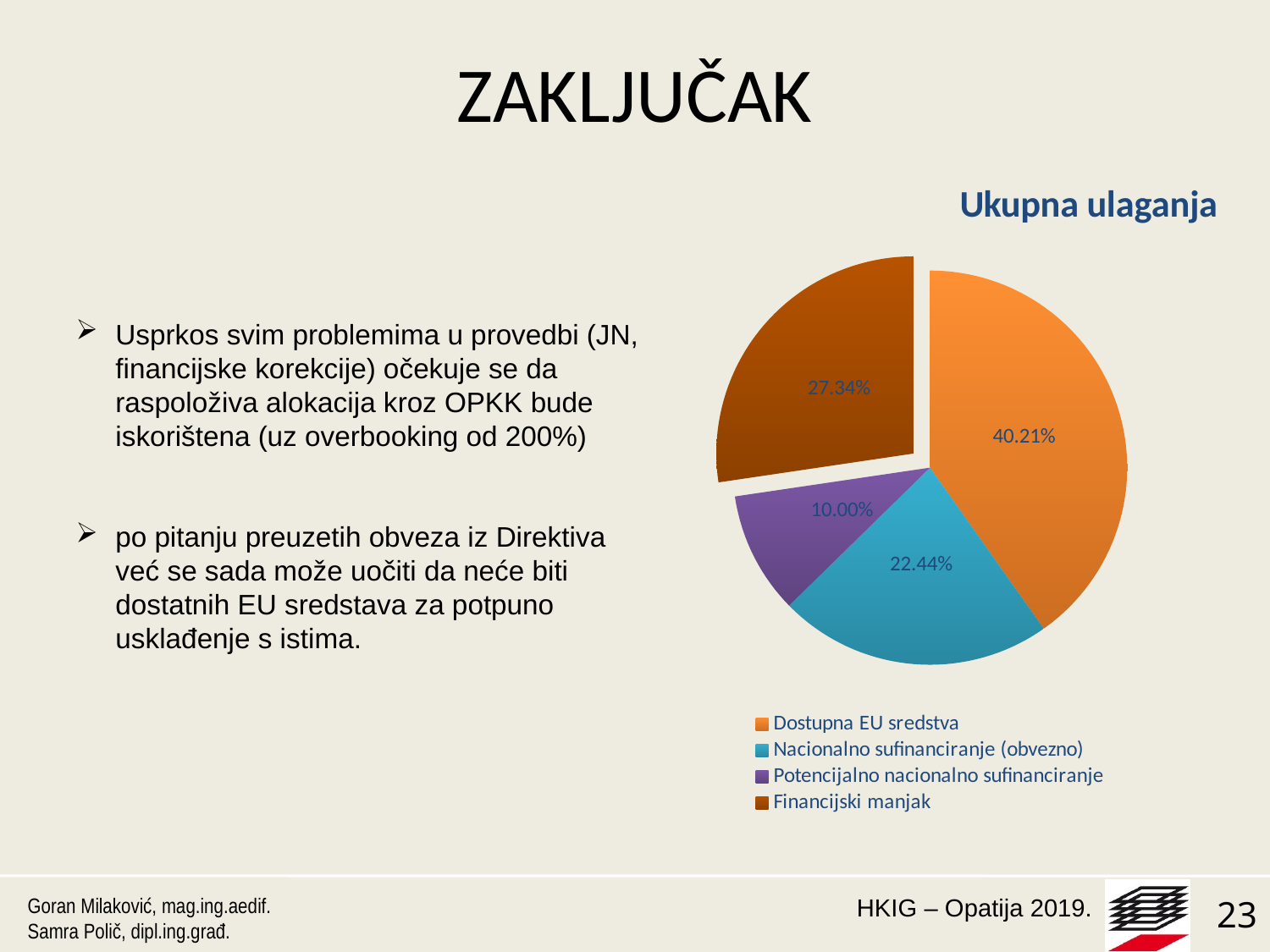
How many slices does the pie chart have? 4 What share of the pie is Nacionalno sufinanciranje (obvezno)? 22.44% What is the title of the chart? Ukupna ulaganja Which slice of the pie is the smallest? Potencijalno nacionalno sufinanciranje Which slice of the pie is the largest? Dostupna EU sredstva Which is larger, the share for Financijski manjak or the share for Nacionalno sufinanciranje (obvezno)? Financijski manjak What share of the pie is Potencijalno nacionalno sufinanciranje? 10.00% What share of the pie is Financijski manjak? 27.34% What share of the pie is Dostupna EU sredstva? 40.21% Which colour represents Financijski manjak in the pie chart? brown What kind of chart is shown on the slide? pie chart What is the difference between the share for Dostupna EU sredstva and the share for Financijski manjak? 12.87%